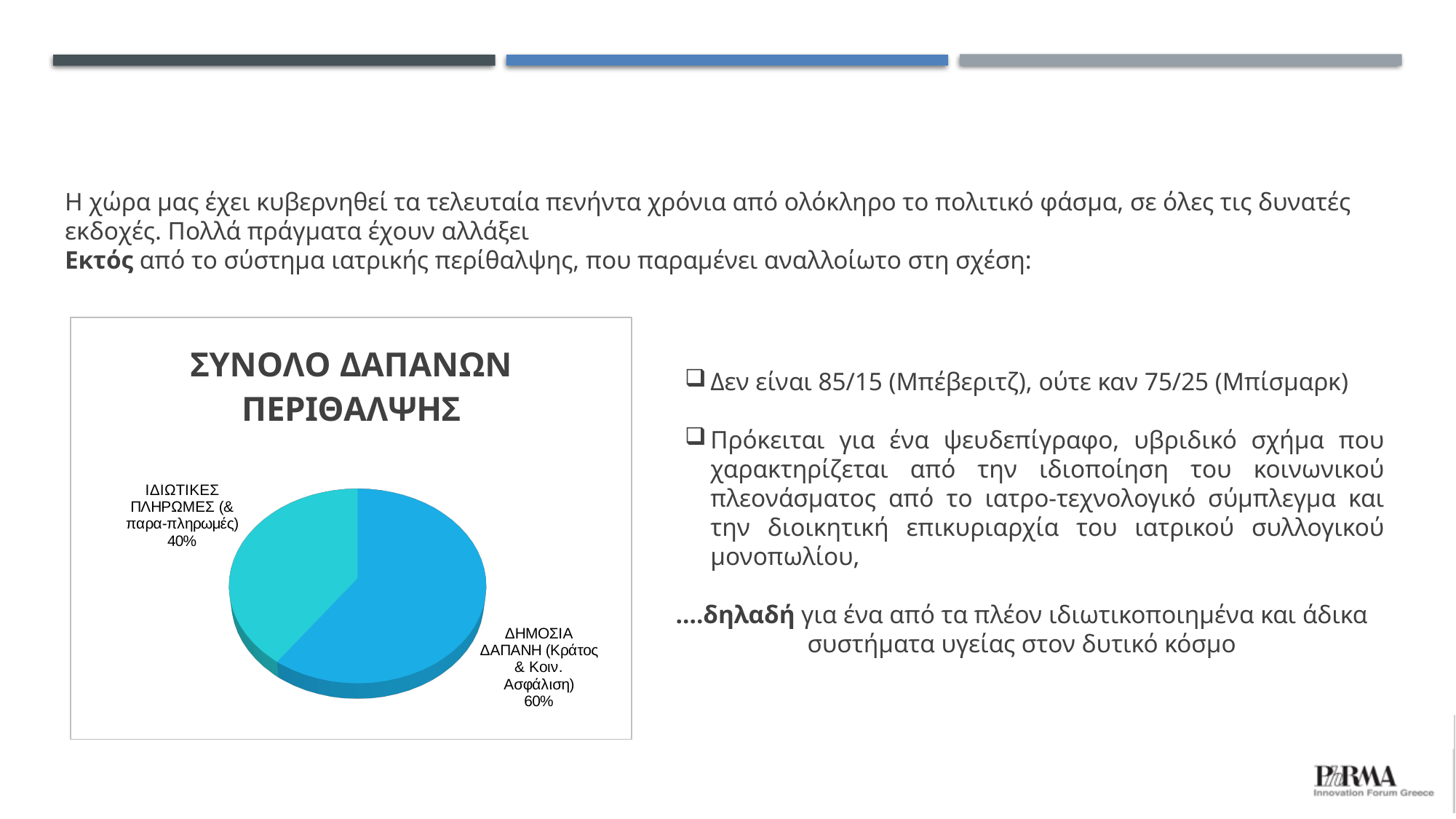
Which slice of the pie chart is the smallest? ΙΔΙΩΤΙΚΕΣ ΠΛΗΡΩΜΕΣ (& παρα-πληρωμές) Which slice of the pie chart is coloured the darker blue? ΔΗΜΟΣΙΑ ΔΑΠΑΝΗ (Κράτος & Κοιν. Ασφάλιση) What share of the pie does the ΙΔΙΩΤΙΚΕΣ ΠΛΗΡΩΜΕΣ (& παρα-πληρωμές) slice represent? 40% What percentage does the pie chart show for ΙΔΙΩΤΙΚΕΣ ΠΛΗΡΩΜΕΣ (& παρα-πληρωμές)? 40% What percentage does the pie chart show for ΔΗΜΟΣΙΑ ΔΑΠΑΝΗ (Κράτος & Κοιν. Ασφάλιση)? 60% Which is larger in the pie chart: ΙΔΙΩΤΙΚΕΣ ΠΛΗΡΩΜΕΣ or ΔΗΜΟΣΙΑ ΔΑΠΑΝΗ? ΔΗΜΟΣΙΑ ΔΑΠΑΝΗ How many slices does the pie chart have? 2 What kind of chart is shown on the slide? Pie chart By how many percentage points does ΔΗΜΟΣΙΑ ΔΑΠΑΝΗ exceed ΙΔΙΩΤΙΚΕΣ ΠΛΗΡΩΜΕΣ in the pie chart? 20 percentage points Which slice of the pie chart is the largest? ΔΗΜΟΣΙΑ ΔΑΠΑΝΗ (Κράτος & Κοιν. Ασφάλιση) What is the title of the pie chart? ΣΥΝΟΛΟ ΔΑΠΑΝΩΝ ΠΕΡΙΘΑΛΨΗΣ